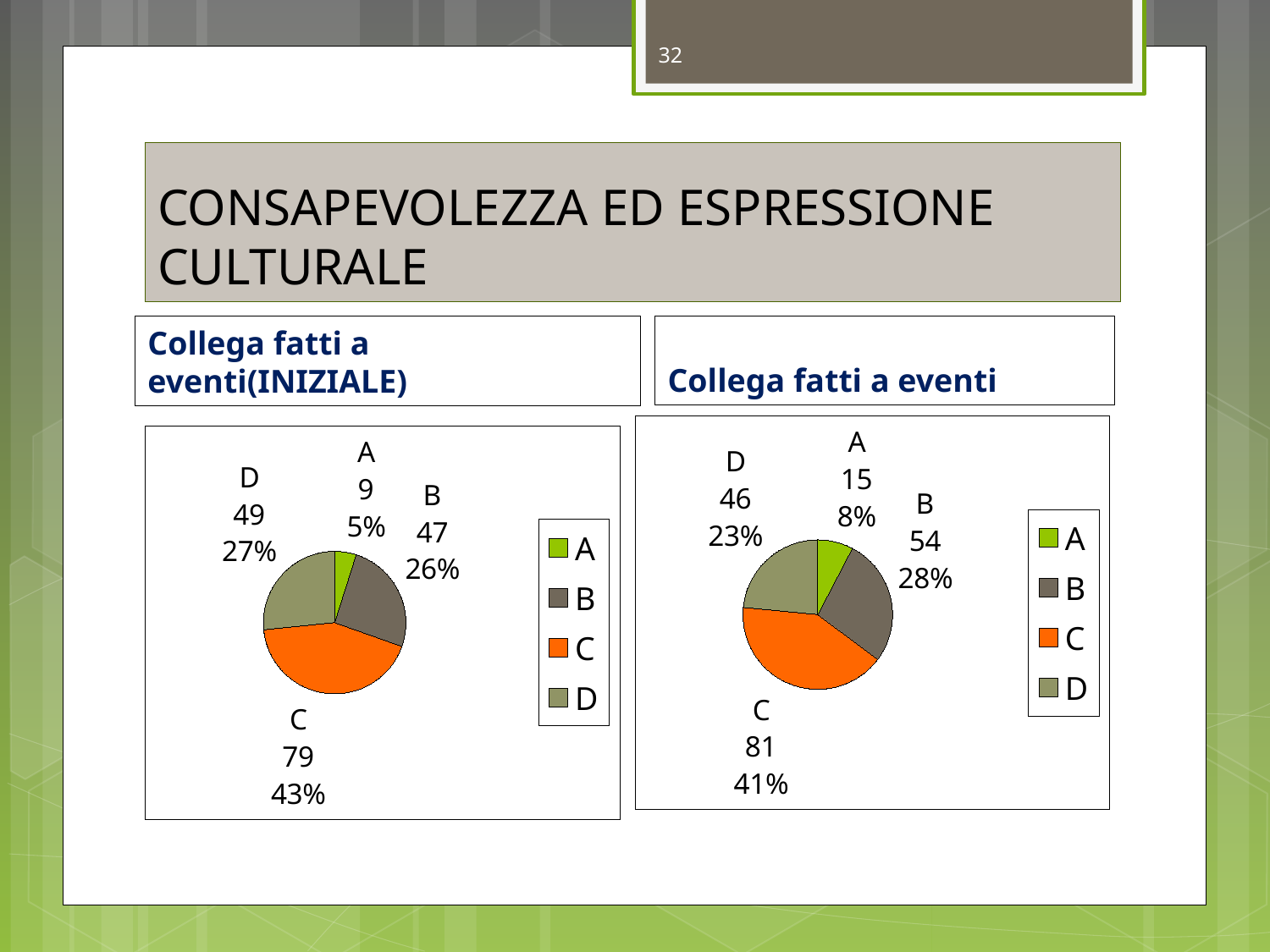
How many slices does the right chart 'Collega fatti a eventi' have? 4 In the right chart 'Collega fatti a eventi', which category has the smallest slice? A In the left chart 'Collega fatti a eventi(INIZIALE)', what percentage share does slice D have? 27% In the left chart 'Collega fatti a eventi(INIZIALE)', which category has the largest slice? C In the left chart 'Collega fatti a eventi(INIZIALE)', what is the total of all four values? 184 In the left chart 'Collega fatti a eventi(INIZIALE)', which is larger, the value for B or the value for D? D What type of chart is the left chart 'Collega fatti a eventi(INIZIALE)'? Pie chart In the left chart 'Collega fatti a eventi(INIZIALE)', what is the value for category C? 79 In the right chart 'Collega fatti a eventi', what is the value for category B? 54 In the right chart 'Collega fatti a eventi', what percentage share does slice A have? 8% In the right chart 'Collega fatti a eventi', what colour is the slice for category C? Orange In the right chart 'Collega fatti a eventi', what is the difference between the values for C and D? 35